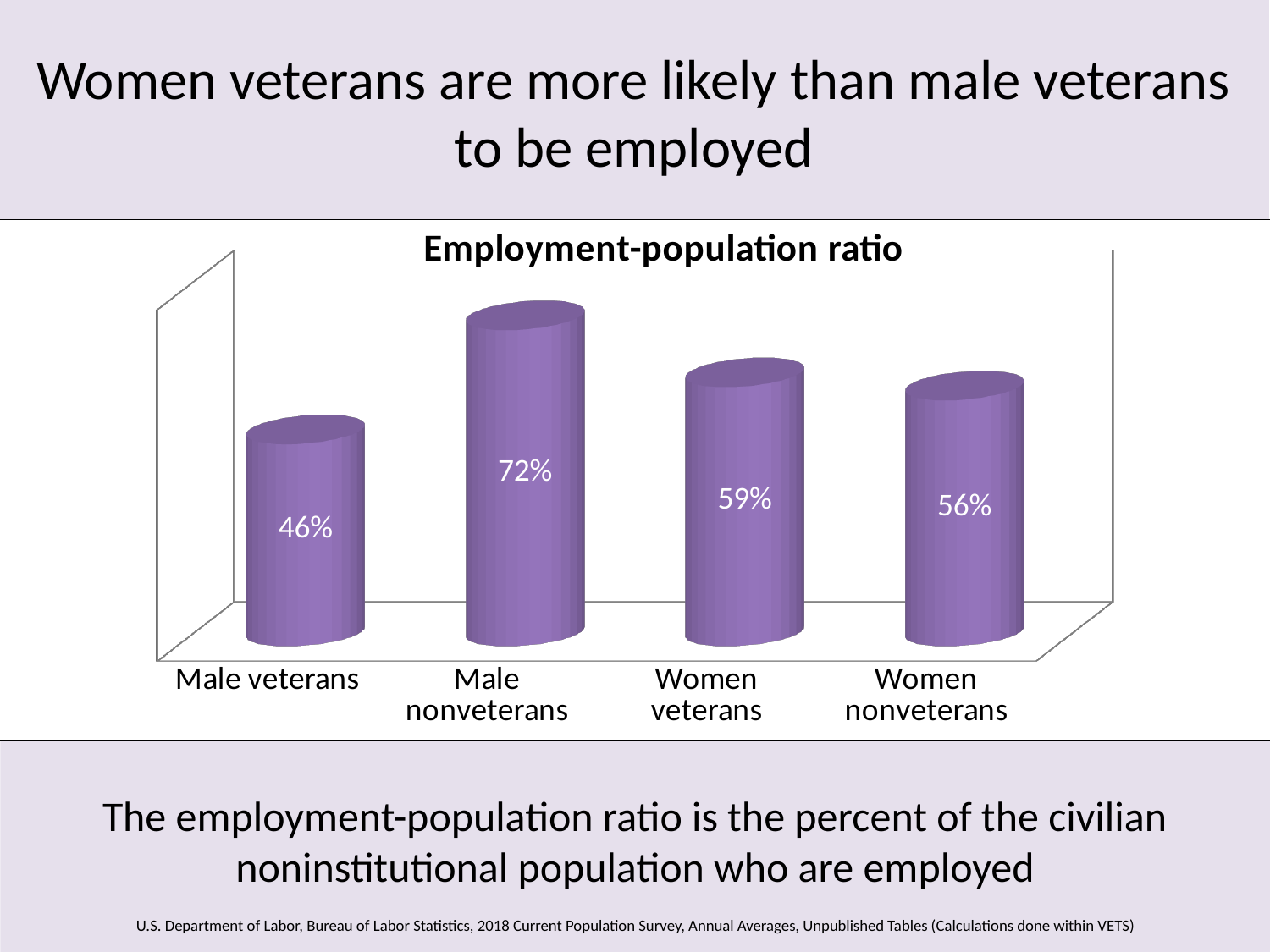
Which has a higher employment-population ratio, Women veterans or Women nonveterans? Women veterans What kind of chart is shown on the slide? Bar chart What is the difference in employment-population ratio between Male nonveterans and Women nonveterans? 16% What is the employment-population ratio for Male veterans? 46% Which category has the lowest employment-population ratio? Male veterans What is the title of the chart? Employment-population ratio What is the employment-population ratio for Male nonveterans? 72% Which category has the highest employment-population ratio? Male nonveterans What is the employment-population ratio for Women nonveterans? 56% What is the employment-population ratio for Women veterans? 59% How many categories are shown in the chart? 4 What is the difference in employment-population ratio between Women veterans and Male veterans? 13%